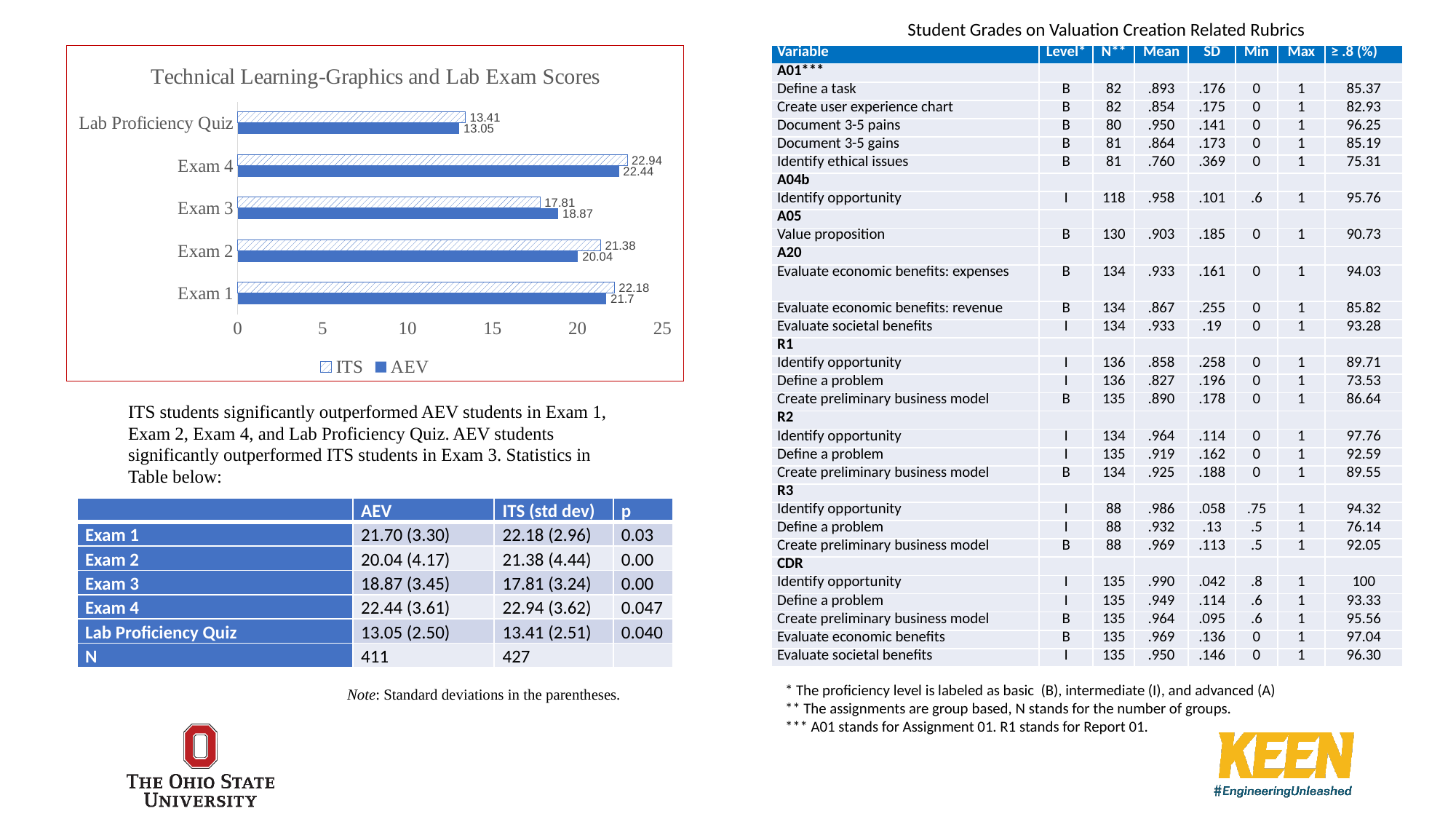
What is the AEV value for Lab Proficiency Quiz in the chart? 13.05 What is the difference between the ITS and AEV values for Exam 2 in the chart? 1.34 How many series does the legend of the chart list? 2 Is the ITS value for Exam 1 in the chart greater or less than 20? greater Which category has the lowest ITS value in the chart? Lab Proficiency Quiz What is the ITS value for Exam 4 in the chart? 22.94 What is the title of the chart on the slide? Technical Learning-Graphics and Lab Exam Scores How many categories are shown on the chart? 5 What kind of chart is used to show the Technical Learning-Graphics and Lab Exam Scores? bar chart In the chart, which is larger for Exam 3: the ITS value or the AEV value? AEV What is the AEV value for Exam 2 in the chart? 20.04 Which category has the highest AEV value in the chart? Exam 4